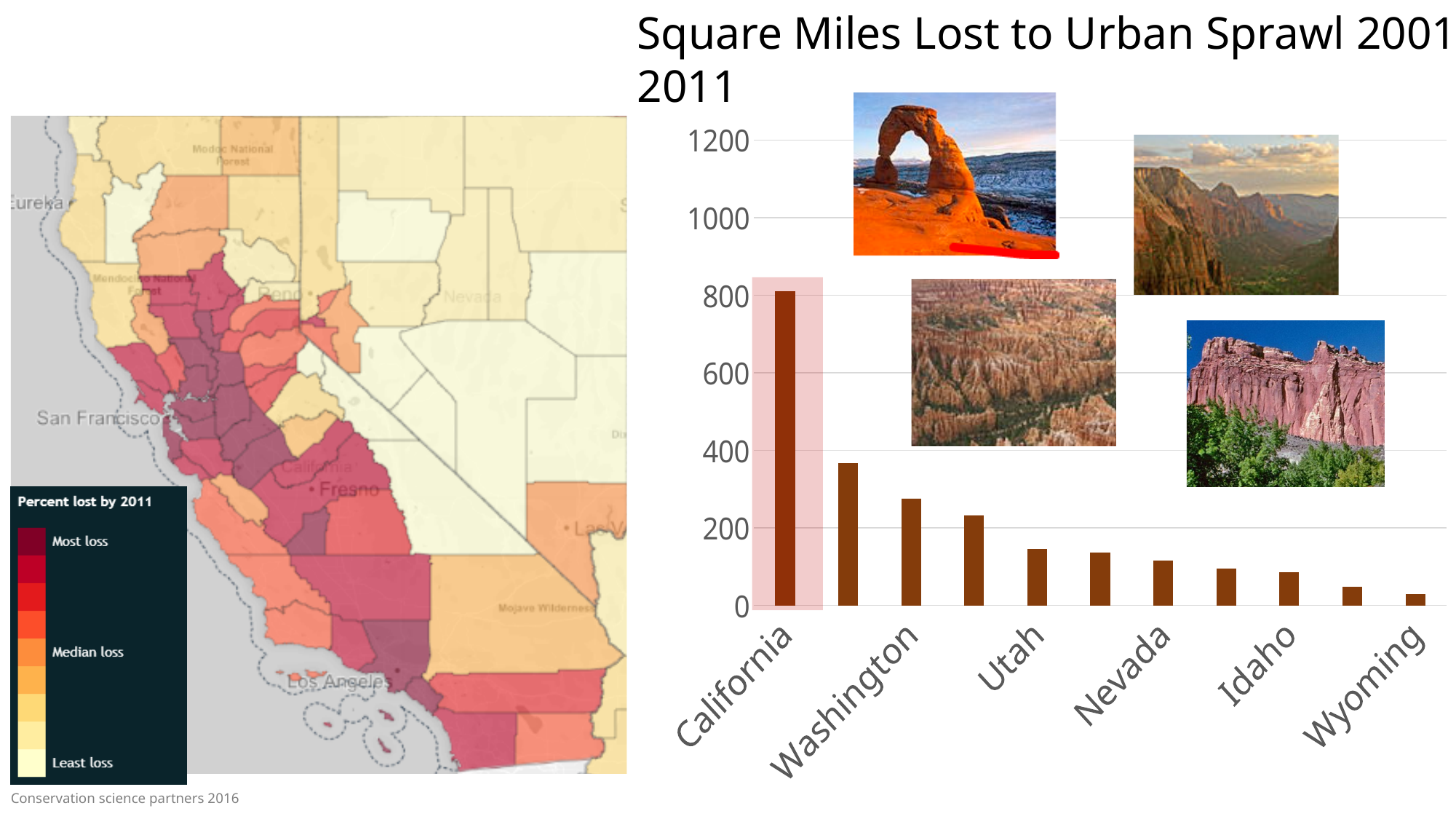
Do the bar values rise or fall from left to right across the chart? fall How many bars are plotted in the Square Miles Lost to Urban Sprawl chart? 11 Is the value for Wyoming greater or less than 100? less Is the value for Washington greater or less than 400? less Which has a larger value, California or Washington? California Is the value for Utah greater or less than 200? less Which state has the highest value in the Square Miles Lost to Urban Sprawl chart? California Which has a larger value, Utah or Wyoming? Utah What kind of chart is shown on the right side of the slide? bar chart Which labelled state has the lowest value in the Square Miles Lost to Urban Sprawl chart? Wyoming